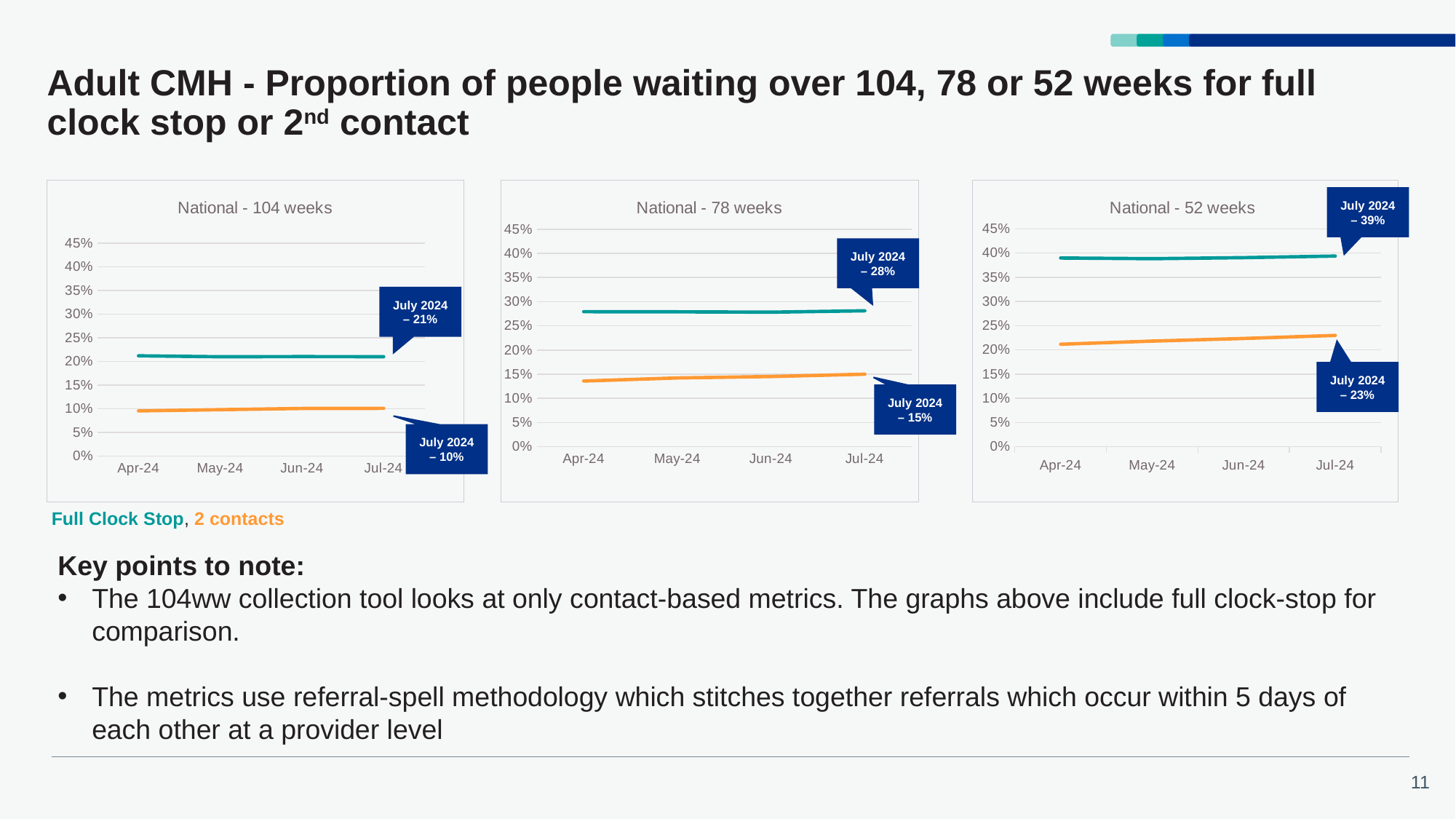
Which series is shown in orange in the charts? 2 contacts How many months are shown on the x axis of the 'National - 52 weeks' chart? 4 In the 'National - 78 weeks' chart, what is the Full Clock Stop value for July 2024? 28% In the 'National - 78 weeks' chart, is the 2 contacts value for Apr-24 greater or less than 20%? less In the 'National - 78 weeks' chart, what is the difference between the Full Clock Stop and 2 contacts values for July 2024? 13% In the 'National - 52 weeks' chart, does the 2 contacts line rise or fall from Apr-24 to Jul-24? Rise In the 'National - 104 weeks' chart, what is the Full Clock Stop value for July 2024? 21% In the 'National - 52 weeks' chart, what is the 2 contacts value for July 2024? 23% In the 'National - 52 weeks' chart, what is the difference between the Full Clock Stop and 2 contacts values for July 2024? 16% In the 'National - 104 weeks' chart, what is the 2 contacts value for July 2024? 10% In the 'National - 104 weeks' chart, which series is higher in July 2024, Full Clock Stop or 2 contacts? Full Clock Stop What kind of chart is 'National - 104 weeks'? Line chart